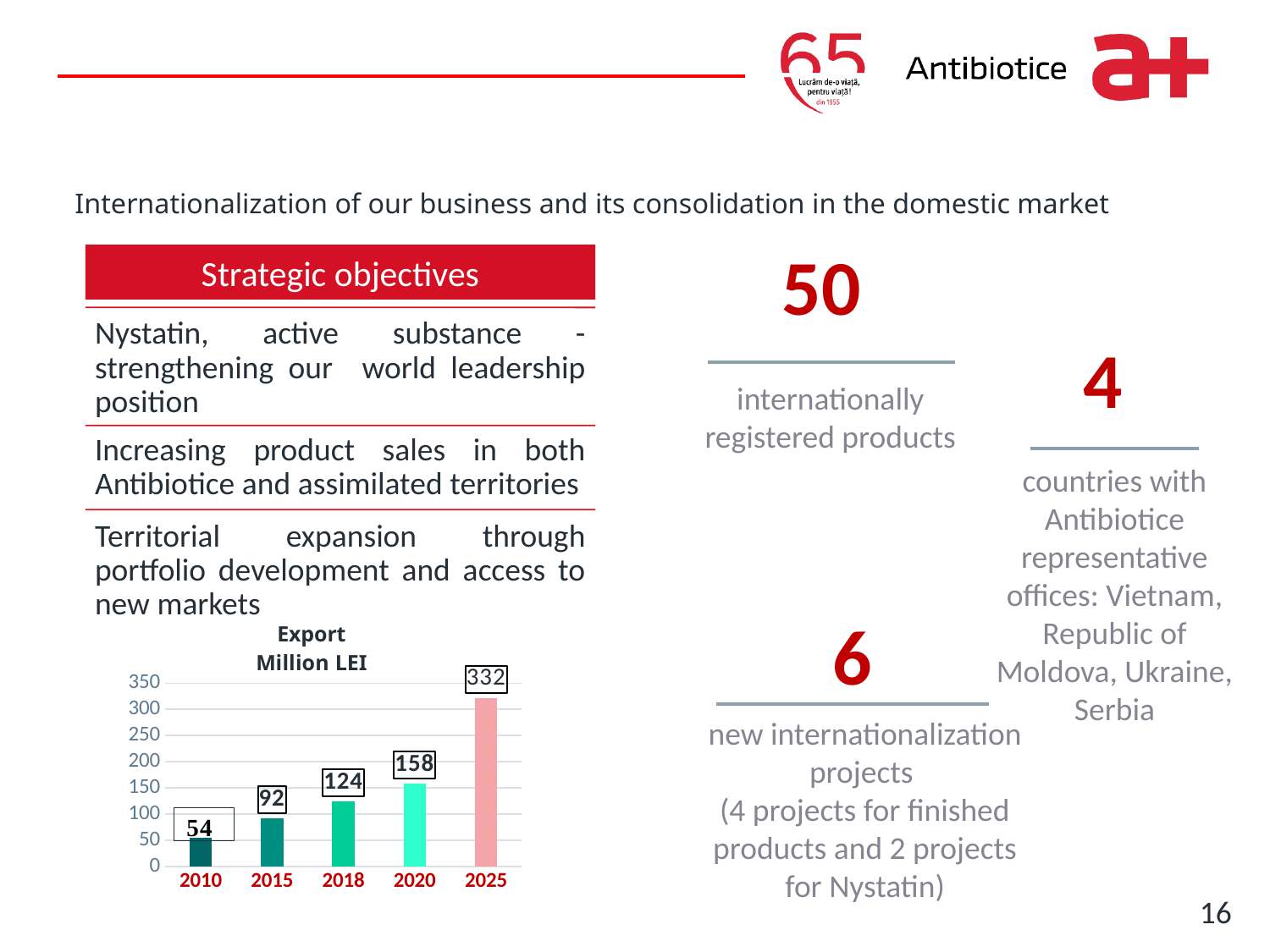
Is the export value for 2025 greater or less than 300? greater What is the difference between the export values for 2025 and 2020? 174 What is the difference between the export values for 2018 and 2015? 32 What is the export value for 2010? 54 What kind of chart is used to show the export data? bar chart Which is larger, the export value for 2015 or for 2018? 2018 Which year has the lowest export value? 2010 How many years are shown on the x axis of the chart? 5 Do the export values rise or fall from 2010 to 2025? rise Which year has the highest export value? 2025 What is the export value for 2020? 158 What is the export value for 2025? 332